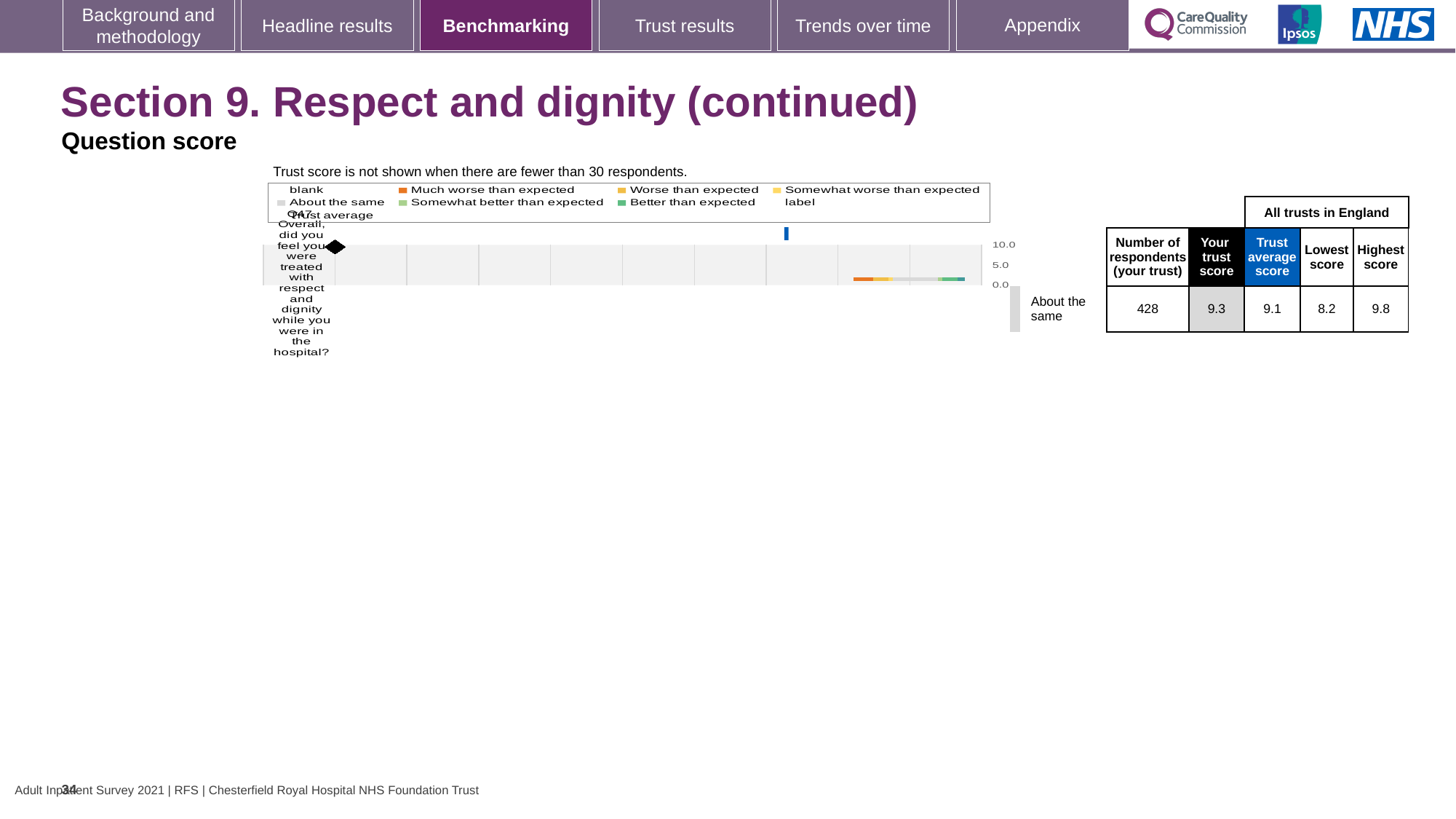
What is the trust average score for all trusts in England for the respect and dignity question? 9.1 What is the trust's score for the question 'Overall, did you feel you were treated with respect and dignity while you were in the hospital?' 9.3 How many respondents from the trust answered the respect and dignity question? 428 Is the trust's score for the respect and dignity question higher or lower than the trust average score? higher What kind of chart is shown on the slide? bar chart What is the highest tick value shown on the chart's score axis? 10.0 Which benchmark category is the trust's result for the respect and dignity question labelled as? About the same What is the highest score among all trusts in England for the respect and dignity question? 9.8 Which legend entry is shown in orange on the chart? Much worse than expected What is the lowest score among all trusts in England for the respect and dignity question? 8.2 What is the difference between the highest score and the lowest score among all trusts in England for the respect and dignity question? 1.6 How many survey questions are plotted on the chart? 1